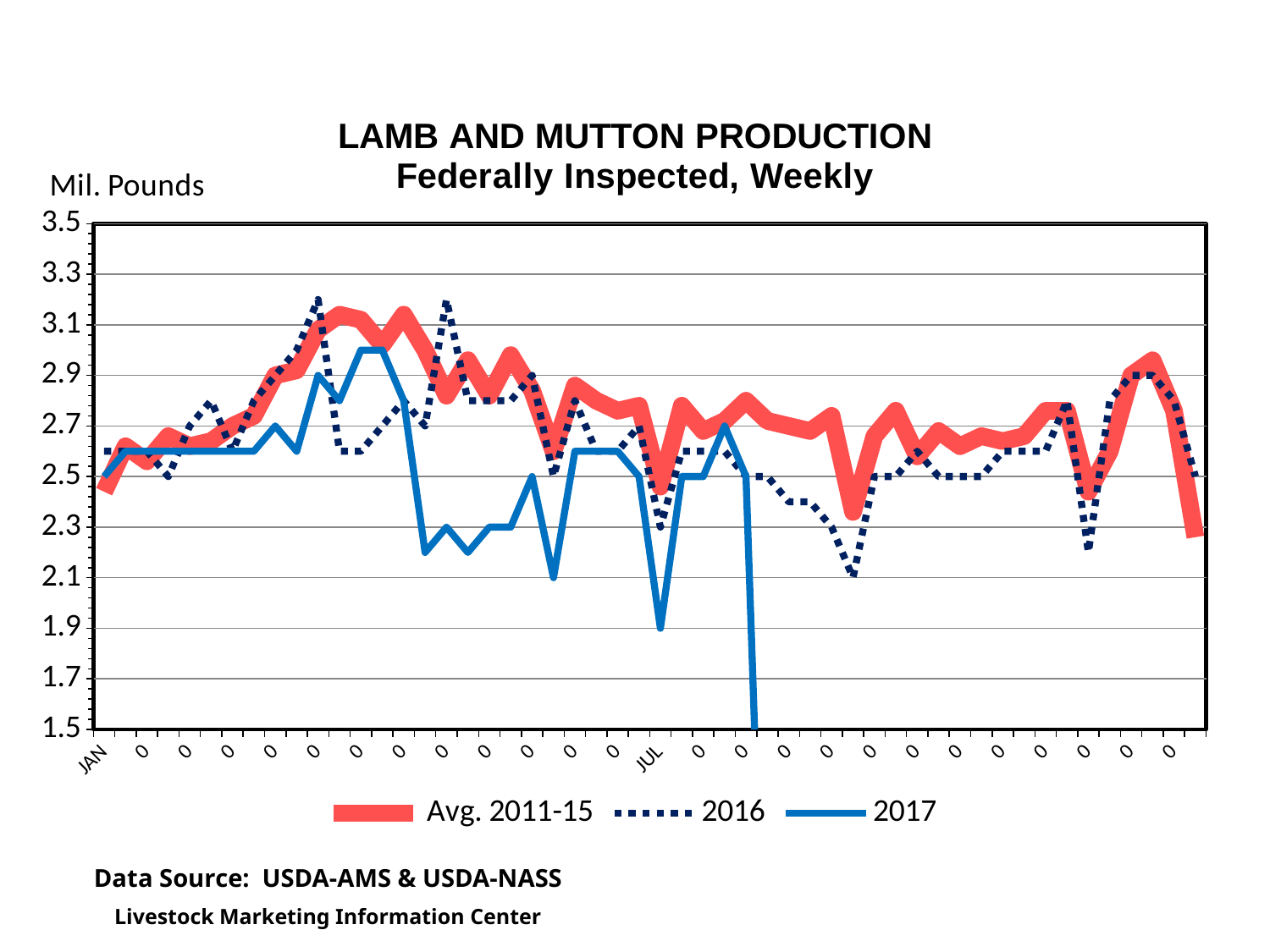
How many series does the legend list? 3 Is the peak value of the 2016 line greater or less than 3.1? greater Which series is drawn as a dotted line? 2016 Is the 2016 value at JAN greater or less than 2.9? less What kind of chart is shown on the slide? Line chart Is the Avg. 2011-15 value at the last week shown greater or less than 2.5? less Which series reaches the lowest value on the chart? 2017 What is the title of the chart? LAMB AND MUTTON PRODUCTION Federally Inspected, Weekly At JUL, which is higher: the Avg. 2011-15 line or the 2017 line? Avg. 2011-15 From JAN through the first few months of the year, does the Avg. 2011-15 line generally rise or fall? rise